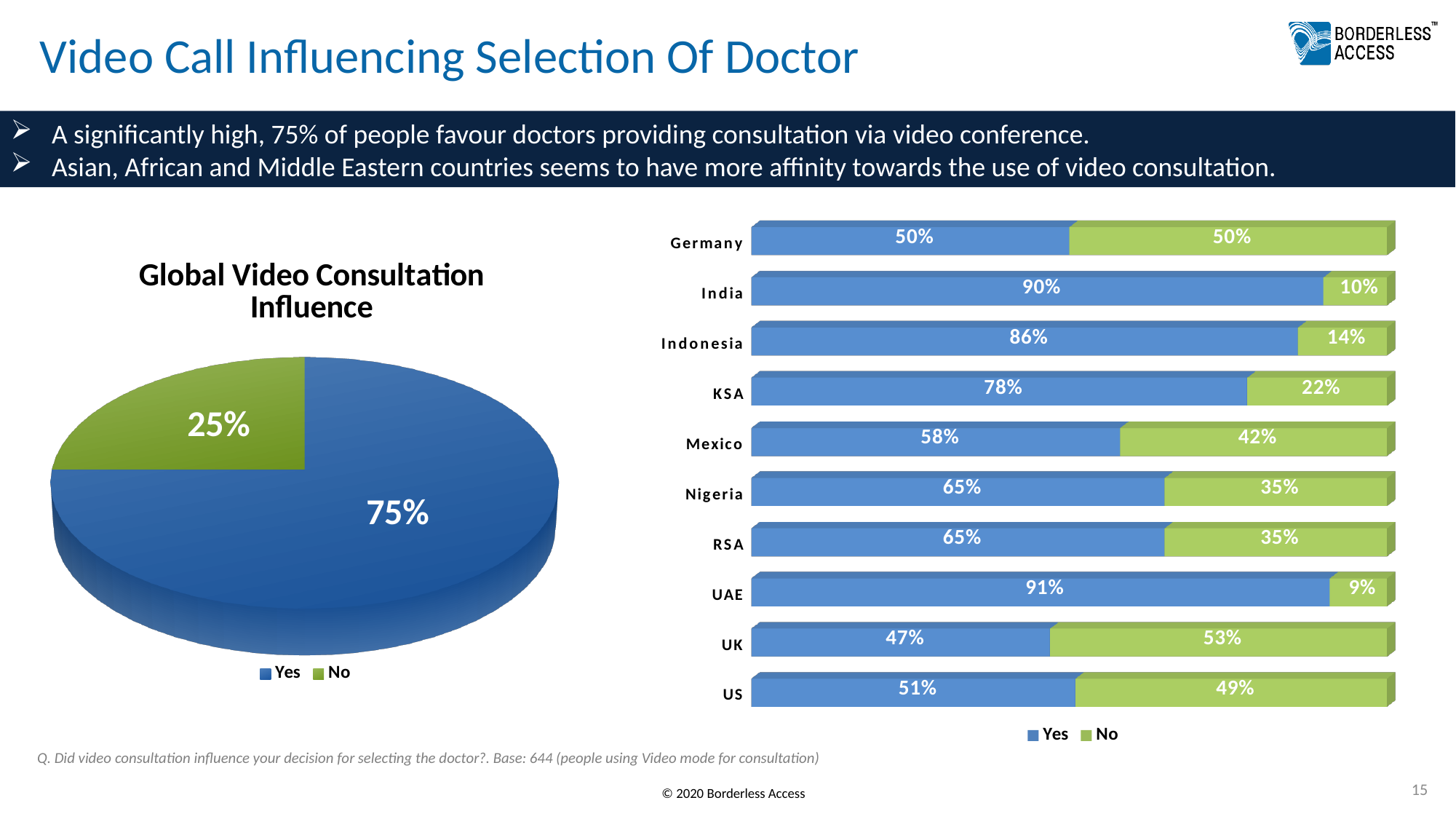
In the bar chart on the right, what is the 'Yes' value for India? 90% How many series does the legend of the bar chart on the right list? 2 In the bar chart on the right, which is larger: the 'No' value for Germany or the 'No' value for Nigeria? Germany In the pie chart titled 'Global Video Consultation Influence', what share of the pie is 'Yes'? 75% In the pie chart titled 'Global Video Consultation Influence', what is the value for 'No'? 25% In the bar chart on the right, what is the 'No' value for Mexico? 42% In the bar chart on the right, which country has the highest 'Yes' value? UAE How many countries are shown in the bar chart on the right? 10 What kind of chart is the chart on the right of the slide? Bar chart In the bar chart on the right, which country has the lowest 'Yes' value? UK What kind of chart is the chart on the left of the slide? Pie chart In the bar chart on the right, what is the difference between the 'Yes' values for Indonesia and KSA? 8%